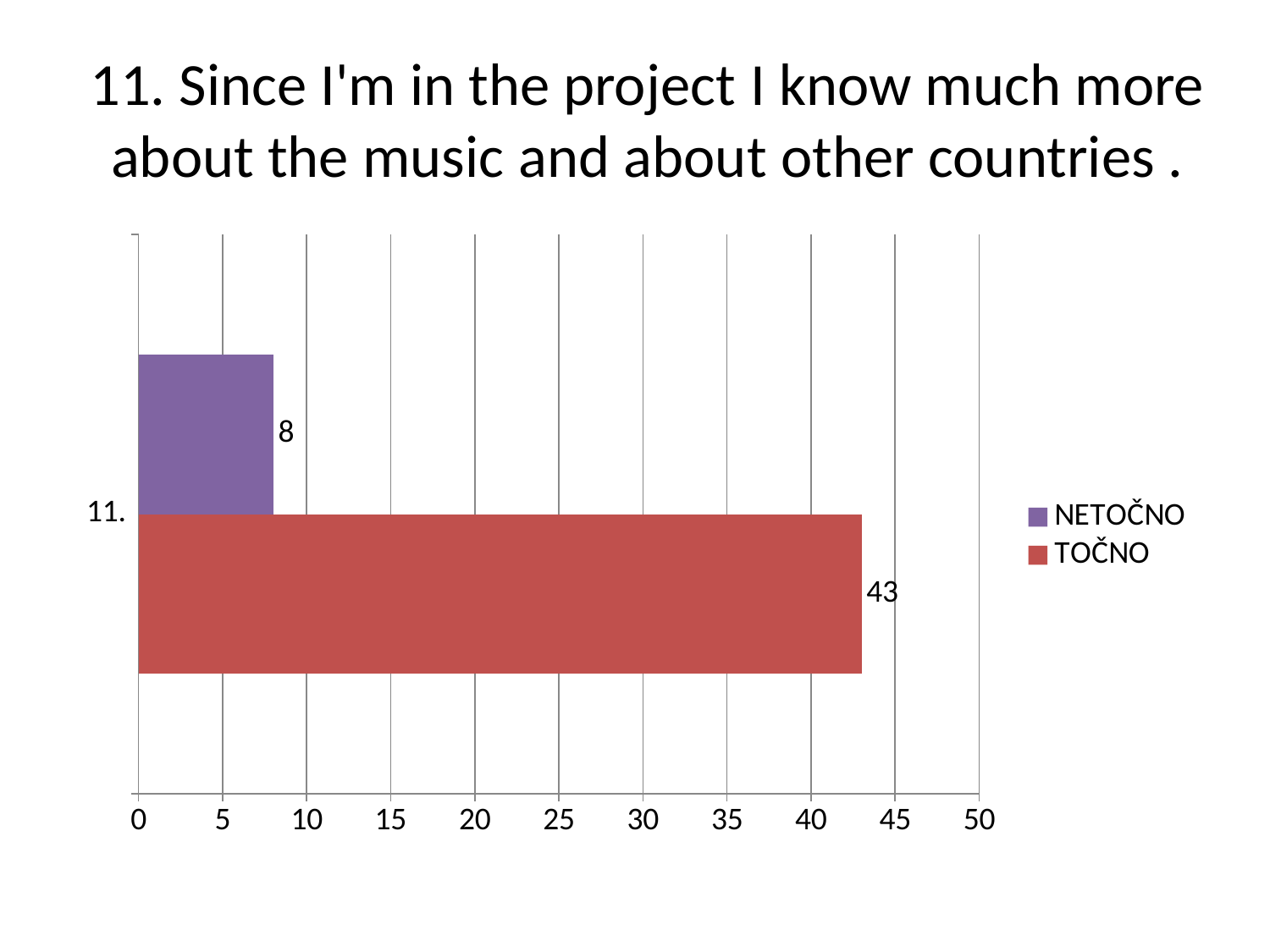
Which series has the higher value, TOČNO or NETOČNO? TOČNO How many series does the legend list? 2 What is the value for NETOČNO? 8 What kind of chart is shown on the slide? bar chart Is the value for TOČNO greater or less than 40? greater What is the difference between the TOČNO and NETOČNO values? 35 What is the value for TOČNO? 43 Is the value for NETOČNO greater or less than 10? less What colour is the TOČNO bar? red What is the total of the TOČNO and NETOČNO values? 51 What is the category label shown on the vertical axis? 11. Which series has the lowest value? NETOČNO